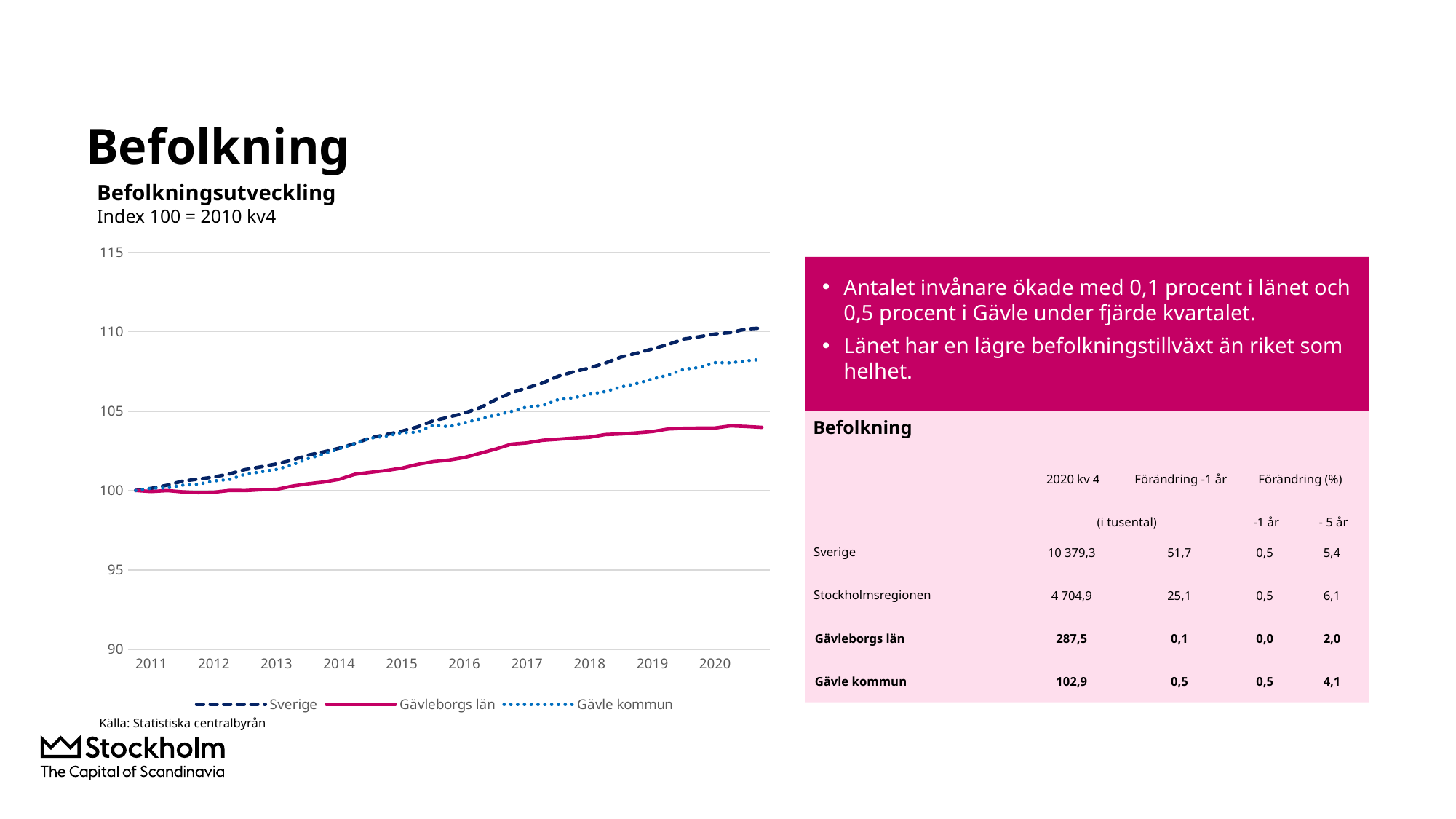
At the end of the chart, which is larger: Gävle kommun or Gävleborgs län? Gävle kommun What kind of chart is shown on the slide? line chart What is the base period of the index used in the chart? 2010 kv4 How many series does the legend of the chart list? 3 Is the value for Sverige at the end of the chart greater or less than 105? greater Does the Sverige line rise or fall from 2011 to 2020? rise Which series is lowest at the right end of the chart (2020)? Gävleborgs län How many year labels are shown on the x axis of the chart? 10 What is the title of the chart? Befolkningsutveckling Is the value for Gävleborgs län at the end of the chart greater or less than 105? less Which series is highest at the right end of the chart (2020)? Sverige Is the value for Gävle kommun at the end of the chart greater or less than 105? greater